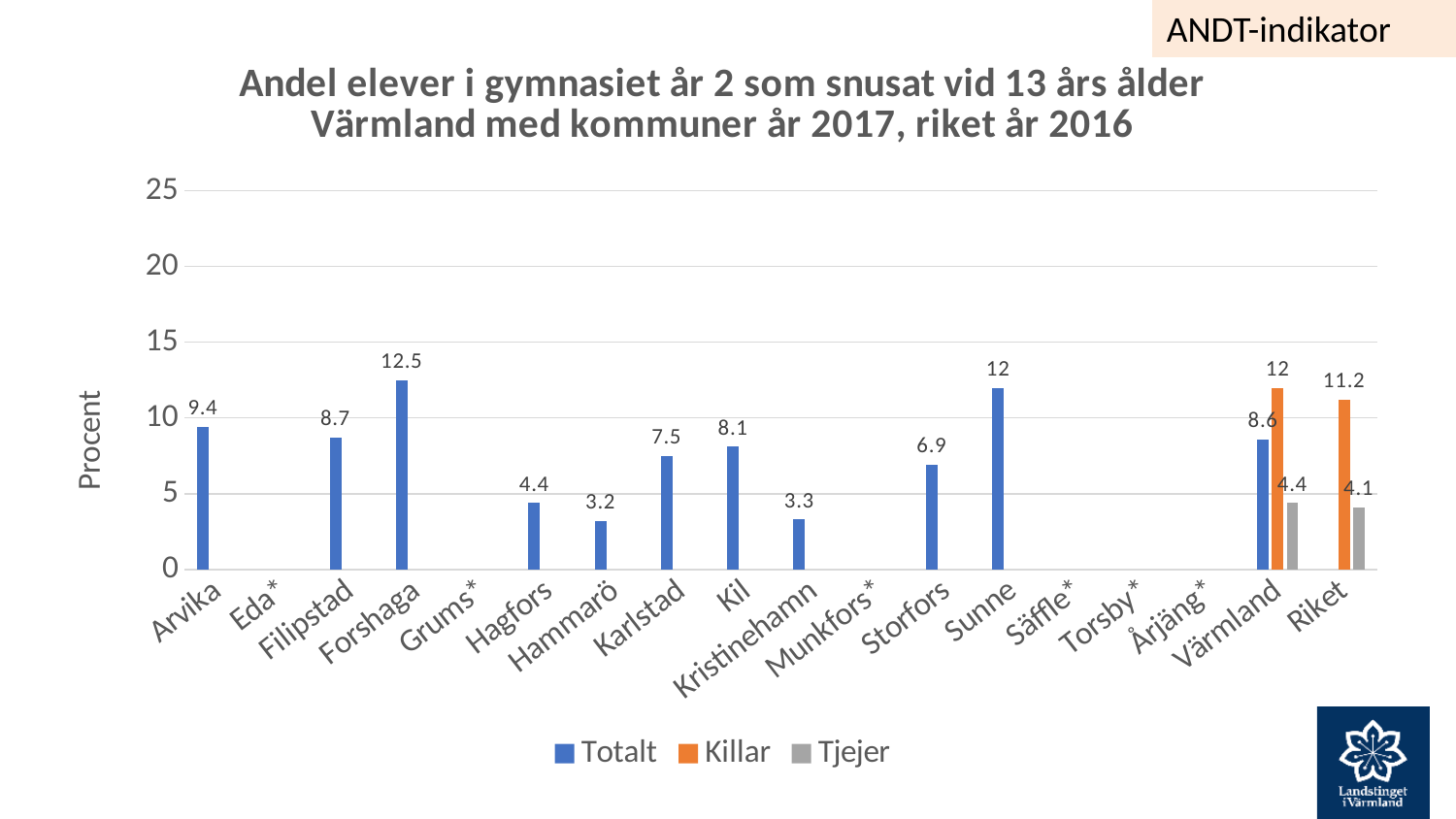
What is the difference between the Totalt values for Forshaga and Sunne? 0.5 How many series does the legend list? 3 What is the difference between the Killar and Tjejer values for Värmland? 7.6 Which has a larger Totalt value, Karlstad or Kil? Kil What is the label on the vertical axis? Procent What is the Killar value for Riket? 11.2 What is the Tjejer value for Värmland? 4.4 Which municipality has the highest Totalt value? Forshaga Is the Totalt value for Storfors greater or less than 5? greater What is the Totalt value for Hammarö? 3.2 What kind of chart is shown on the slide? Bar chart What is the Totalt value for Forshaga? 12.5